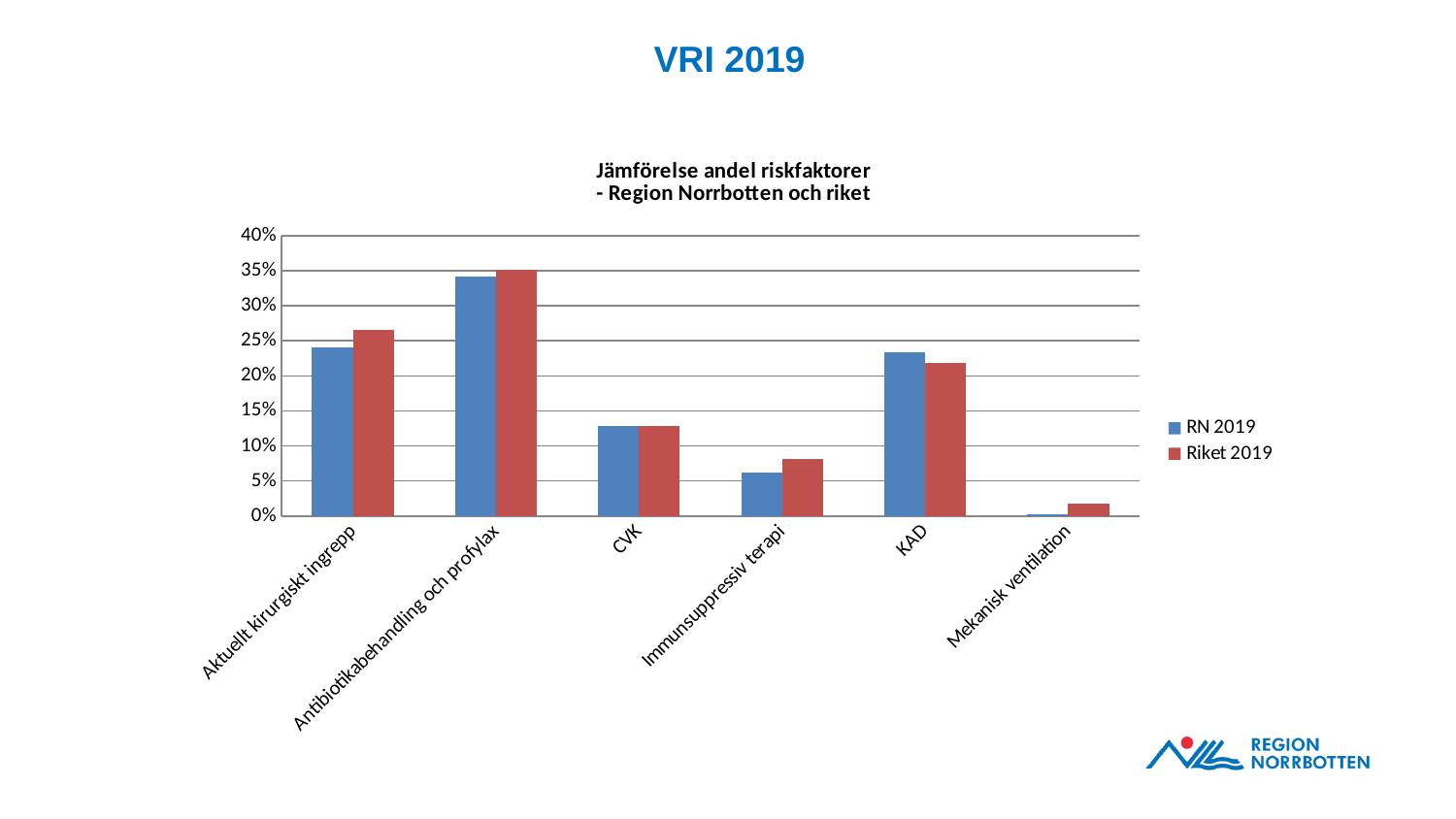
Which category has the highest value for RN 2019? Antibiotikabehandling och profylax For Aktuellt kirurgiskt ingrepp, which series has the larger value, RN 2019 or Riket 2019? Riket 2019 Which category has the lowest value for Riket 2019? Mekanisk ventilation What is the title of the chart? Jämförelse andel riskfaktorer - Region Norrbotten och riket Is the Riket 2019 value for Immunsuppressiv terapi greater or less than 10%? less For Immunsuppressiv terapi, which series has the larger value, RN 2019 or Riket 2019? Riket 2019 Is the RN 2019 value for Antibiotikabehandling och profylax greater or less than 30%? greater How many categories are shown on the x axis? 6 How many series does the legend list? 2 Is the Riket 2019 value for Mekanisk ventilation greater or less than 5%? less What kind of chart is shown on the slide? bar chart